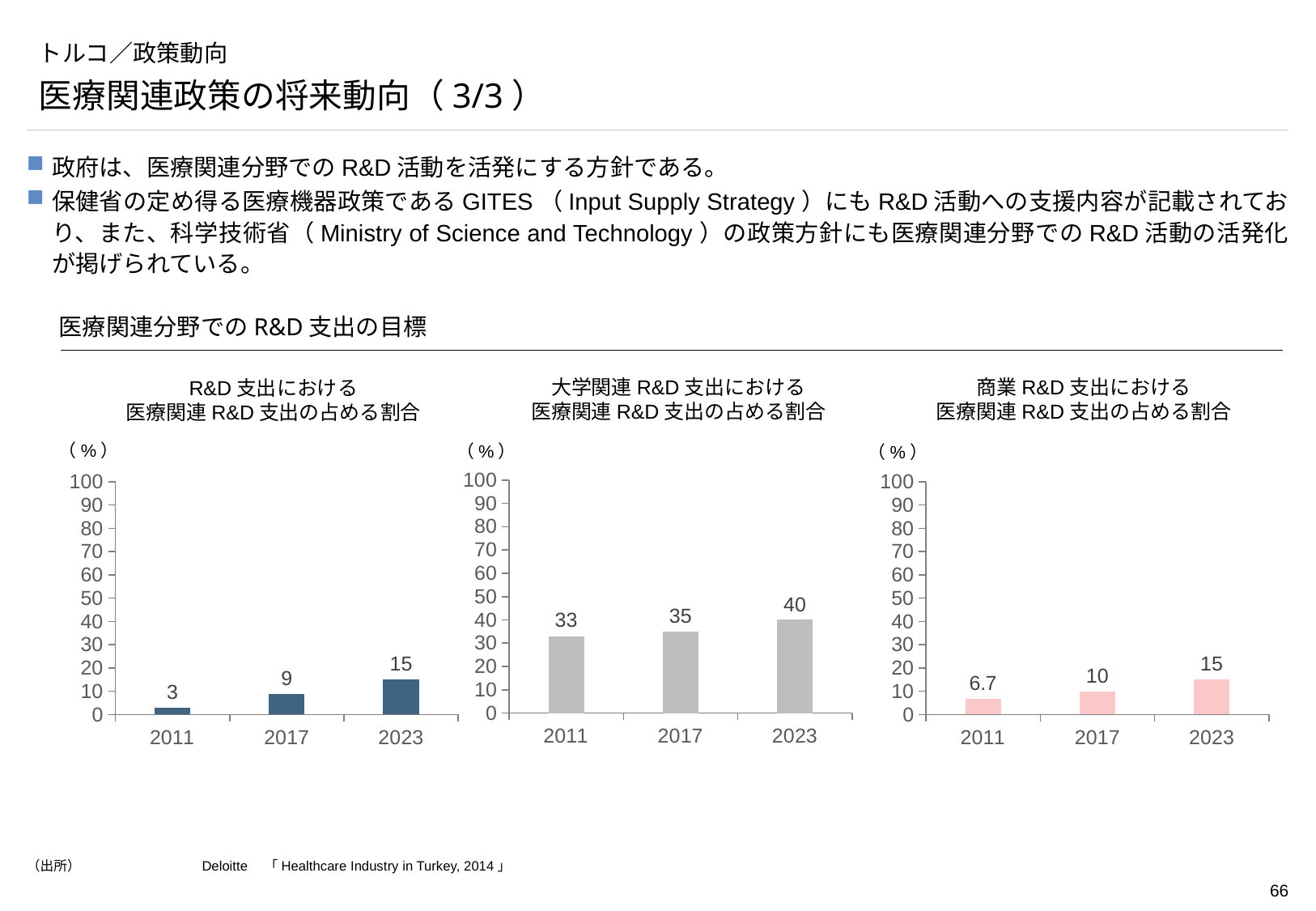
In the right chart (商業R&D支出における医療関連R&D支出の占める割合), what is the value for 2011? 6.7 In the middle chart (大学関連R&D支出における医療関連R&D支出の占める割合), which year has the highest value? 2023 What kind of chart is the left chart (R&D支出における医療関連R&D支出の占める割合)? Bar chart In the middle chart (大学関連R&D支出における医療関連R&D支出の占める割合), is the value for 2011 greater or less than 50? less In the middle chart (大学関連R&D支出における医療関連R&D支出の占める割合), what is the difference between the 2023 and 2011 values? 7 In the right chart (商業R&D支出における医療関連R&D支出の占める割合), which year has the lowest value? 2011 In the left chart (R&D支出における医療関連R&D支出の占める割合), what is the value for 2011? 3 In the left chart (R&D支出における医療関連R&D支出の占める割合), what is the value for 2023? 15 In the left chart (R&D支出における医療関連R&D支出の占める割合), what is the difference between the 2023 and 2011 values? 12 Which is larger: the 2017 value in the middle chart (大学関連) or the 2017 value in the right chart (商業)? The middle chart (大学関連), 35 How many years (categories) are shown in the right chart (商業R&D支出における医療関連R&D支出の占める割合)? 3 In the middle chart (大学関連R&D支出における医療関連R&D支出の占める割合), what is the value for 2017? 35